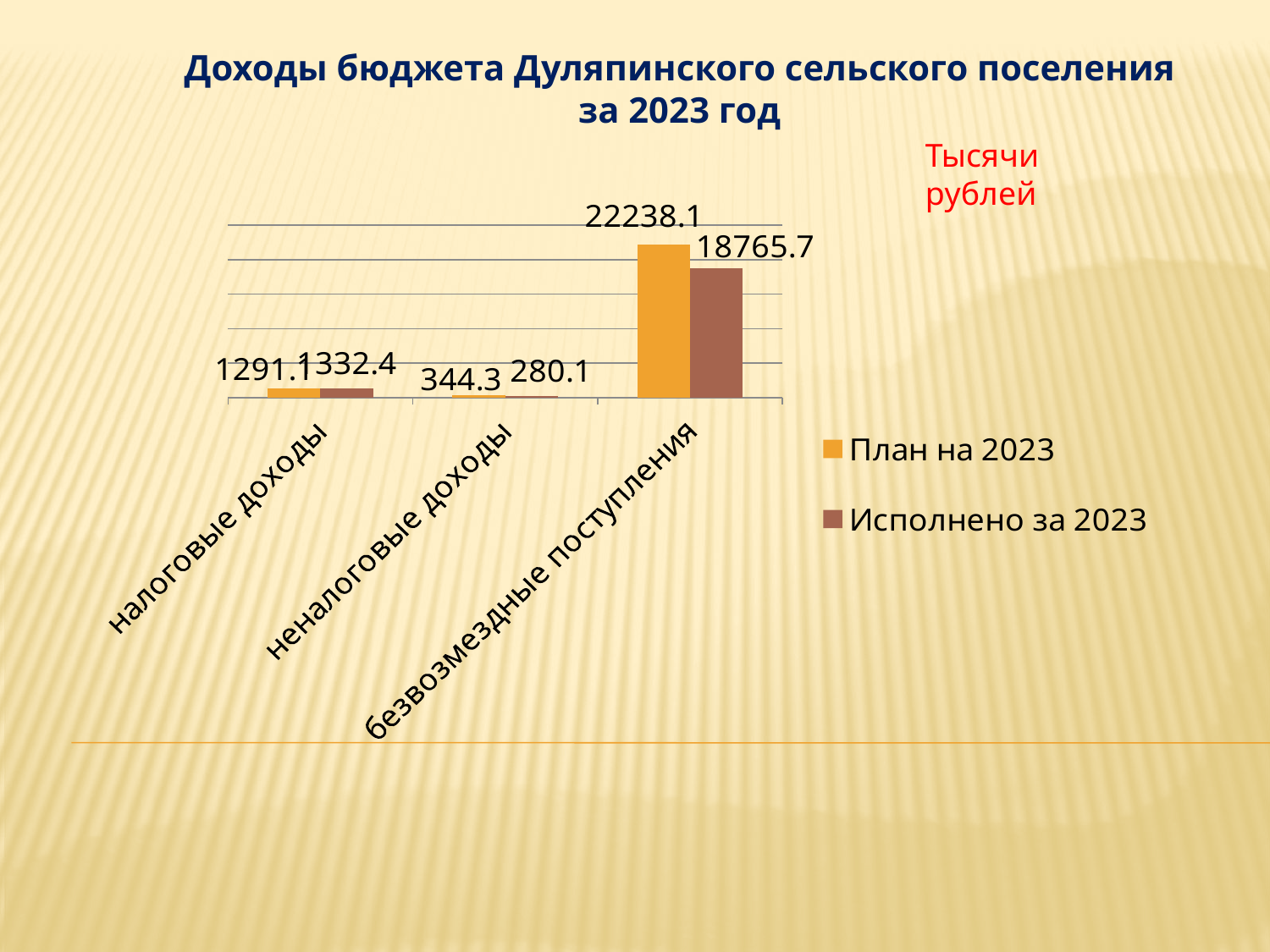
Which category has the lowest executed value (Исполнено за 2023)? неналоговые доходы How many series does the legend list? 2 For неналоговые доходы, which is larger: the planned value or the executed value? the planned value (344.3) What is the difference between the planned and executed values for безвозмездные поступления? 3472.4 What is the difference between the executed and planned values for налоговые доходы? 41.3 Which category has the highest planned value (План на 2023)? безвозмездные поступления What is the planned value (План на 2023) for налоговые доходы? 1291.1 What is the executed value (Исполнено за 2023) for неналоговые доходы? 280.1 What kind of chart is shown on the slide? bar chart What is the executed value (Исполнено за 2023) for безвозмездные поступления? 18765.7 How many categories are shown on the x axis? 3 What is the planned value (План на 2023) for безвозмездные поступления? 22238.1